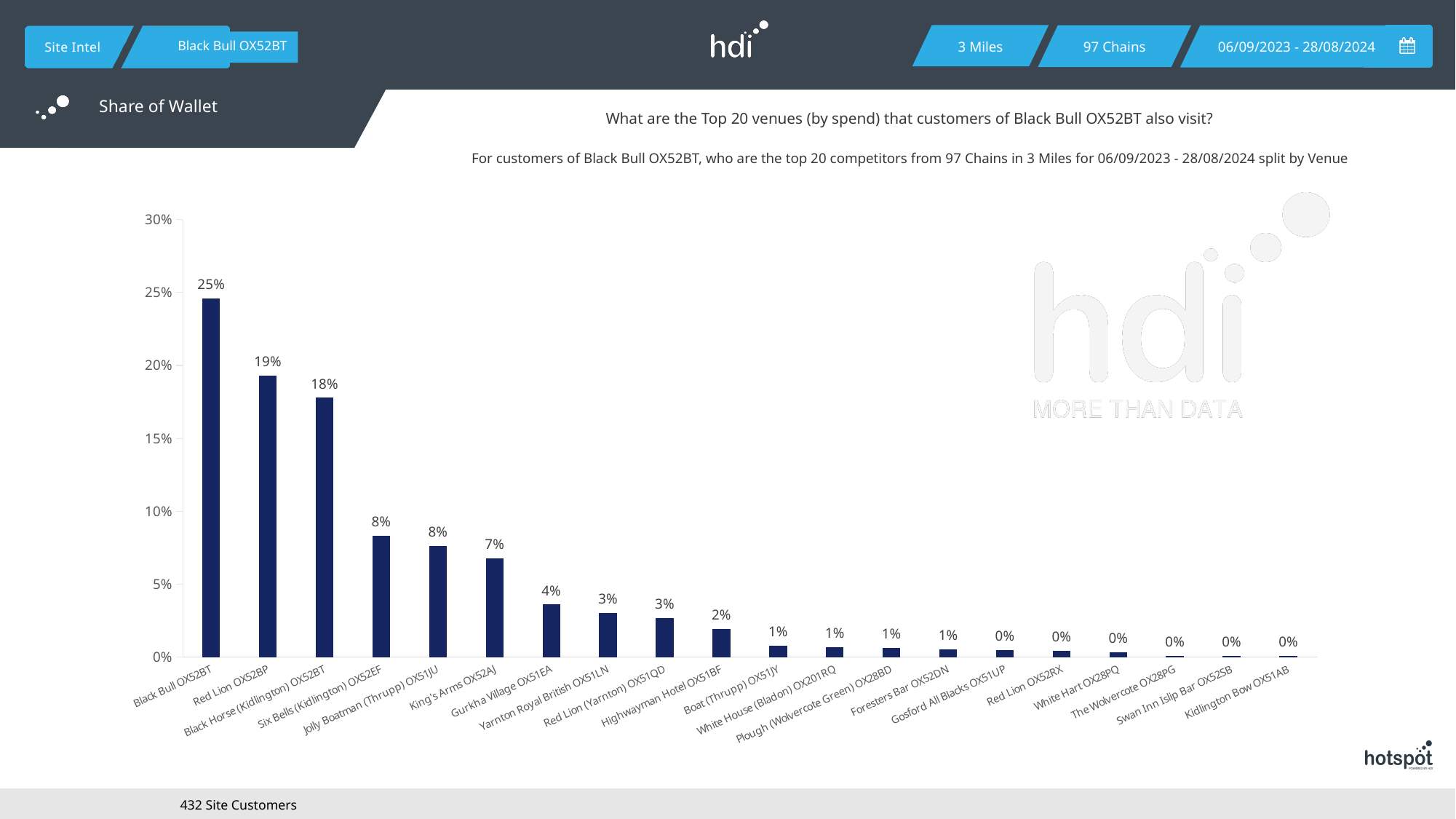
What is the value for Highwayman Hotel OX51BF? 2% What is the value for Red Lion OX52BP? 19% Which venue has the highest value? Black Bull OX52BT What is the value for Gurkha Village OX51EA? 4% Do the values rise or fall moving from left to right along the x axis? fall How many venues are shown on the chart? 20 What is the value for Black Bull OX52BT? 25% What kind of chart is shown on the slide? bar chart What is the difference between the values for Black Bull OX52BT and Red Lion OX52BP? 6% Which is larger, the value for Red Lion OX52BP or Black Horse (Kidlington) OX52BT? Red Lion OX52BP Is the value for Black Horse (Kidlington) OX52BT greater or less than 15%? greater What is the value for Six Bells (Kidlington) OX52EF? 8%